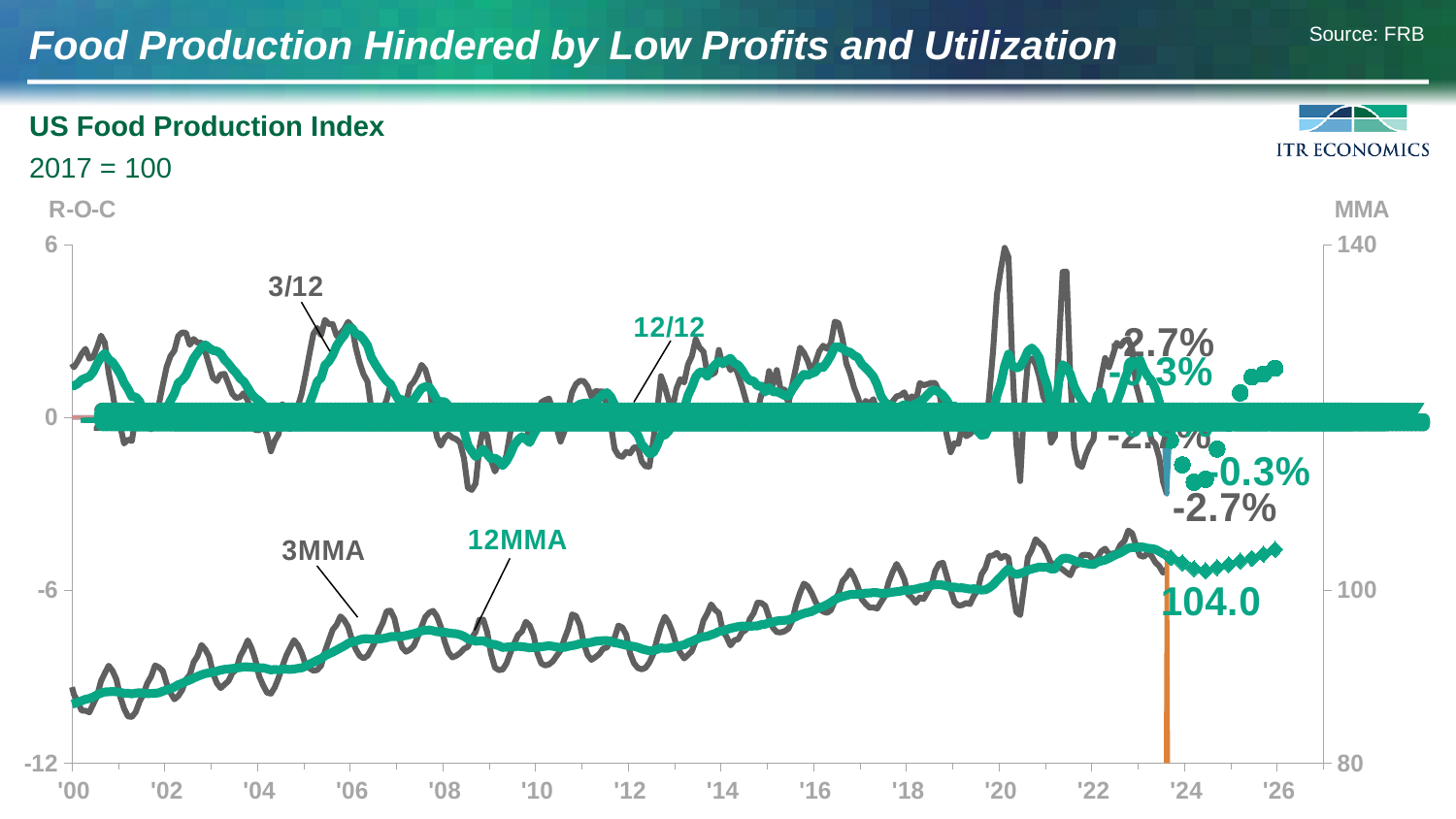
How many year labels are shown on the x axis? 14 Is the 12MMA value in '22 greater or less than 100 on the MMA axis? greater Is the 12/12 value in '09 greater or less than 0? less What is the latest labeled value of the 12MMA series? 104.0 Is the 12MMA value in '00 greater or less than 100 on the MMA axis? less How many series are labeled on the chart? 4 What kind of chart is shown on the slide? line chart What source is cited for the chart? FRB Does the 12MMA series generally rise or fall from '00 to '23? rise What is the title of the chart? US Food Production Index Which series is higher in '06, the 12MMA or the 3MMA at its peak? 3MMA